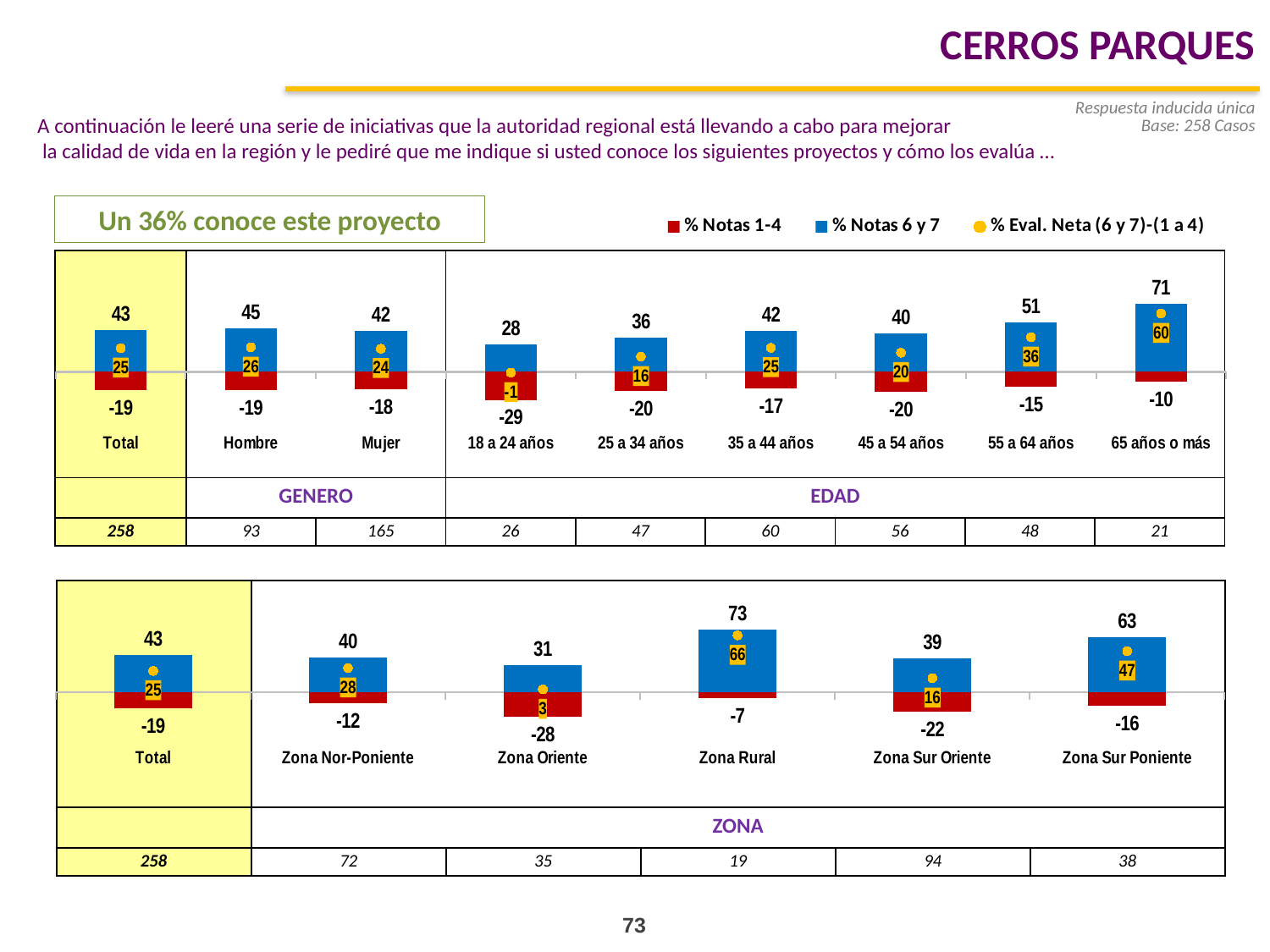
How many series does the legend list for the charts on this slide? 3 In the bottom chart, what is the % Eval. Neta value for Zona Oriente? 3 In the bottom chart, which zone has the highest % Eval. Neta value? Zona Rural In the top chart, which category has the highest % Notas 6 y 7 value? 65 años o más In the top chart, what is the % Notas 6 y 7 value for 65 años o más? 71 In the top chart, what is the difference between the % Notas 6 y 7 values for Hombre and Mujer? 3 In the top chart, what is the % Notas 1-4 value for 18 a 24 años? -29 In the bottom chart, what is the % Notas 6 y 7 value for Zona Rural? 73 In the top chart, which category has the lowest % Eval. Neta value? 18 a 24 años In the top chart, what is the % Eval. Neta value for Hombre? 26 In the bottom chart, is the % Notas 6 y 7 value larger for Zona Sur Poniente or Zona Sur Oriente? Zona Sur Poniente What kind of chart is the bottom chart? Bar chart